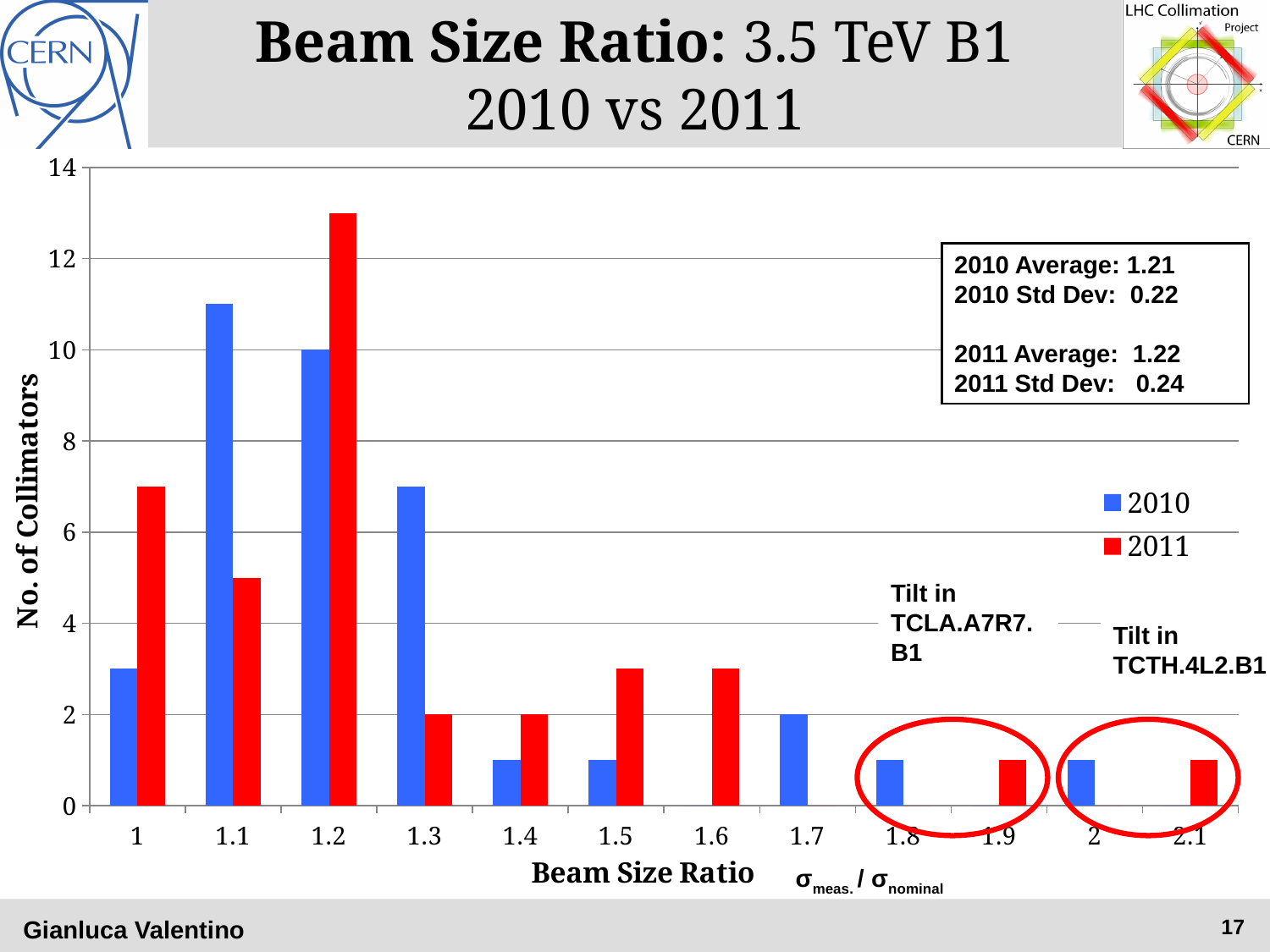
Is the number of collimators for 2011 at beam size ratio 1.2 greater or less than 12? greater At beam size ratio 1, which series has the larger number of collimators, 2010 or 2011? 2011 At beam size ratio 1.1, which series has the larger number of collimators, 2010 or 2011? 2010 Which colour represents the 2011 series in the legend? red What kind of chart is shown on the slide? bar chart Is the number of collimators for 2011 at beam size ratio 1.5 greater or less than 4? less What is the number of collimators for 2010 at beam size ratio 1.7? 2 Which beam size ratio category has the tallest bar for the 2010 series? 1.1 Which beam size ratio category has the tallest bar for the 2011 series? 1.2 Is the number of collimators for 2010 at beam size ratio 1.3 greater or less than 6? greater How many beam size ratio categories are shown on the x axis? 12 How many series does the legend list? 2